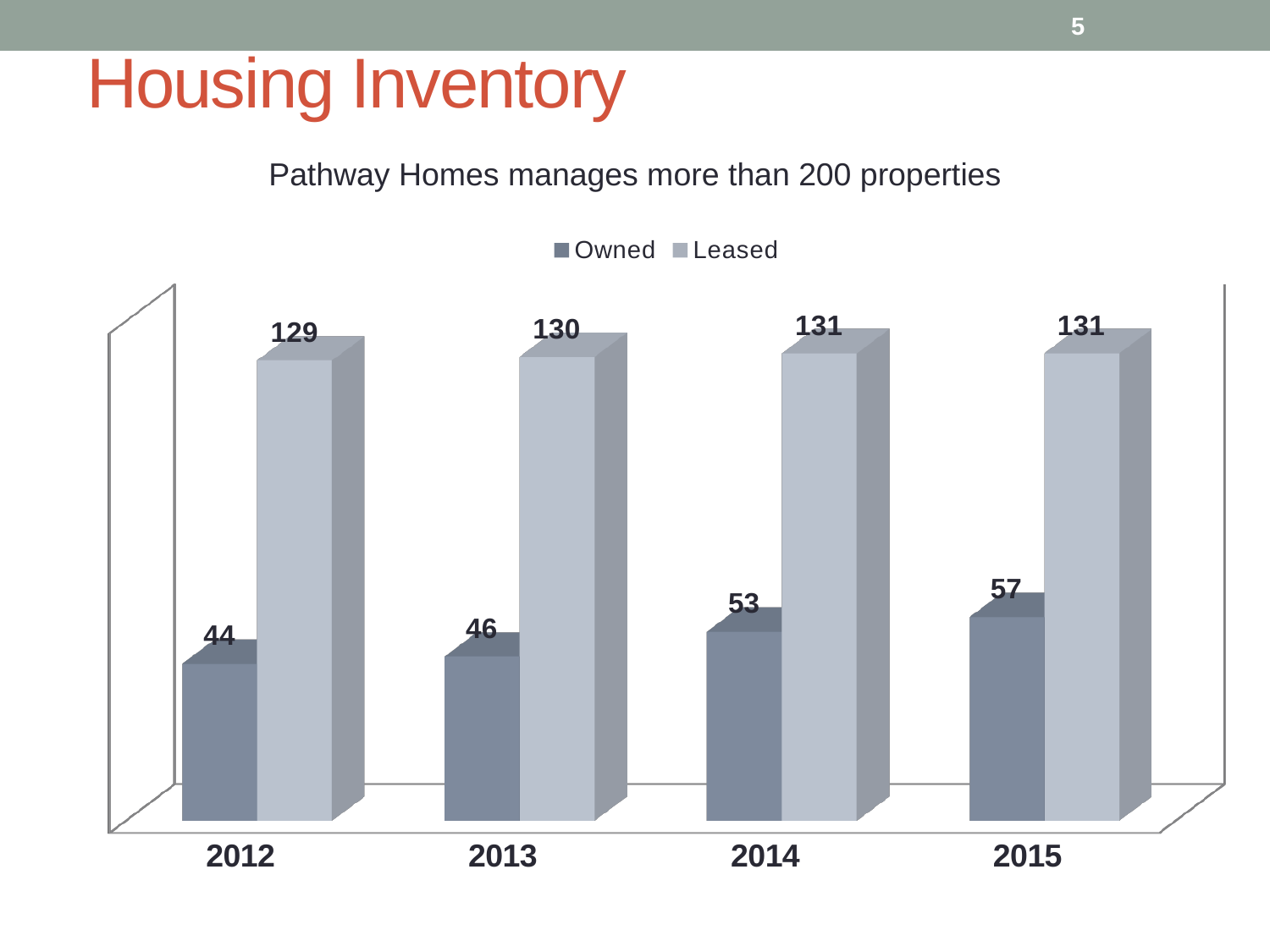
What kind of chart is shown on the slide? Bar chart Which year has the highest Owned value? 2015 Which year has the lowest Leased value? 2012 By how much did the Owned value increase from 2012 to 2015? 13 What is the difference between the Leased and Owned values in 2013? 84 What is the value for Owned in 2015? 57 Which is larger in 2014, the Owned value or the Leased value? Leased What is the value for Owned in 2012? 44 What is the value for Leased in 2014? 131 How many years are shown on the x axis? 4 How many series does the legend list? 2 Does the Owned value rise or fall from 2012 to 2015? Rise